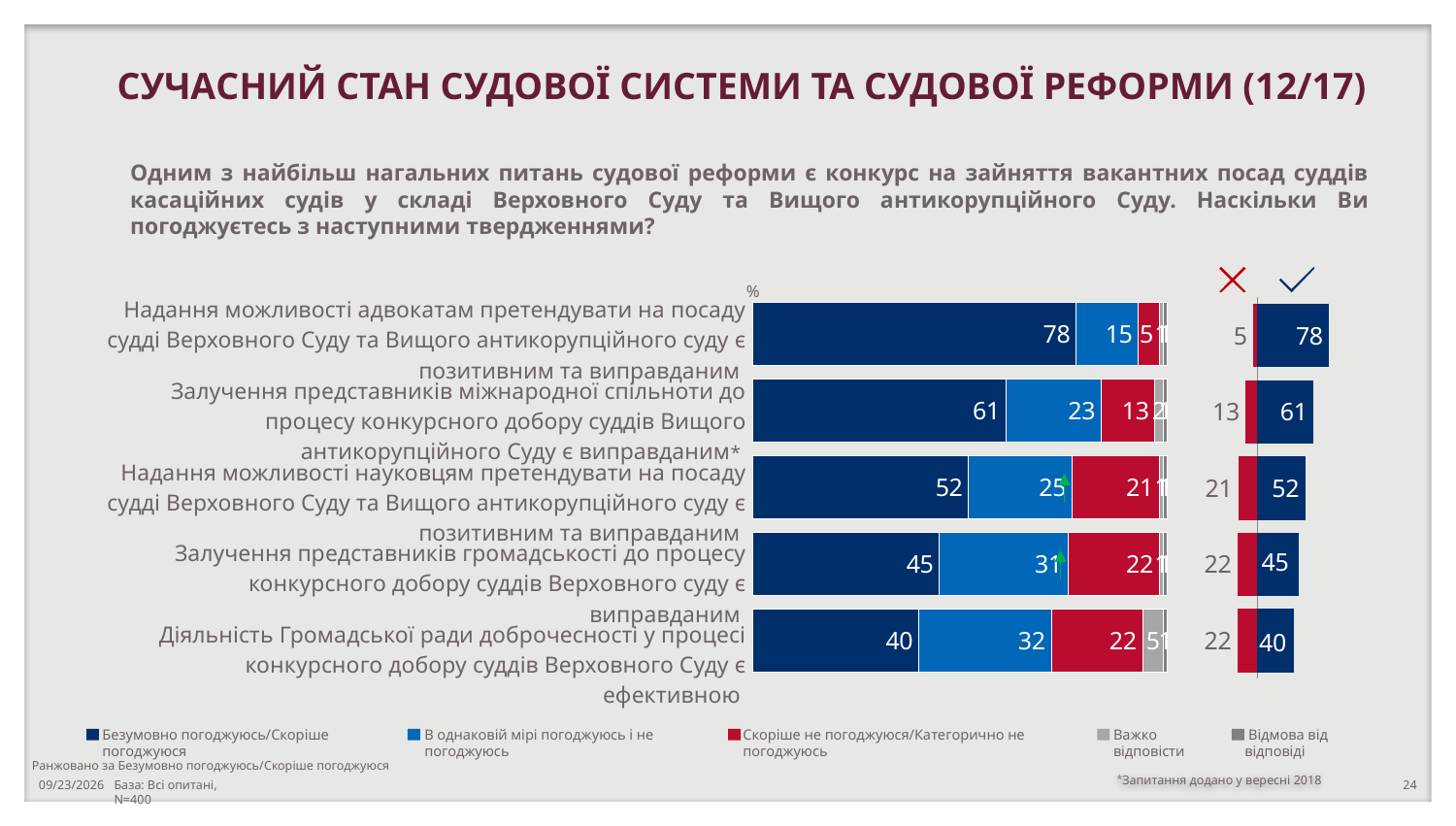
What percentage chose "Скоріше не погоджуюся/Категорично не погоджуюсь" for the statement about involving representatives of the international community (міжнародної спільноти)? 13 What is the "Важко відповісти" value for the statement about the activity of the Громадська рада доброчесності? 5 Which has a larger "В однаковій мірі погоджуюсь і не погоджуюсь" share: the statement about involving the public (громадськості) or the statement about scholars (науковцям)? Залучення представників громадськості до процесу конкурсного добору суддів Верховного суду є виправданим What percentage of respondents chose "Безумовно погоджуюсь/Скоріше погоджуюся" for the statement about giving lawyers (адвокатам) the opportunity to apply for judge positions? 78 What is the "В однаковій мірі погоджуюсь і не погоджуюсь" value for the statement about the activity of the Громадська рада доброчесності? 32 How many statements are shown in the chart? 5 How many series does the legend list? 5 Which statement has the highest share of "Безумовно погоджуюсь/Скоріше погоджуюся"? Надання можливості адвокатам претендувати на посаду судді Верховного Суду та Вищого антикорупційного суду є позитивним та виправданим What type of chart is used on this slide? Stacked bar chart According to the note under the chart, by which response category are the statements ranked? Безумовно погоджуюсь/Скоріше погоджуюся By how many percentage points does the agreement ("Безумовно погоджуюсь/Скоріше погоджуюся") for the statement about lawyers (адвокатам) exceed that for the statement about the Громадська рада доброчесності? 38 Which statement has the lowest share of "Безумовно погоджуюсь/Скоріше погоджуюся"? Діяльність Громадської ради доброчесності у процесі конкурсного добору суддів Верховного Суду є ефективною